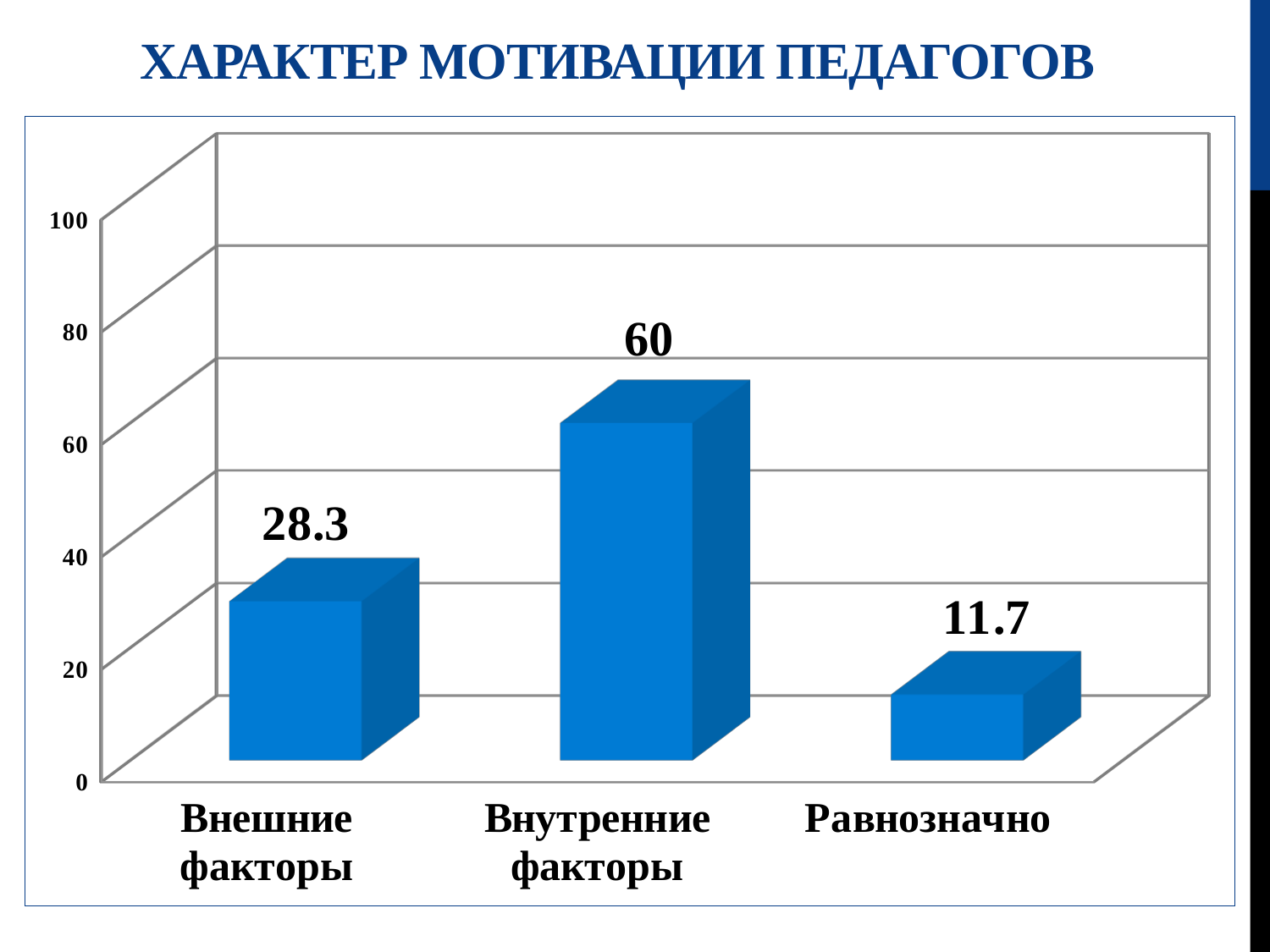
What is the value for Внешние факторы? 28.3 What is the difference between the values for Внутренние факторы and Внешние факторы? 31.7 Which category has the highest value? Внутренние факторы What is the value for Равнозначно? 11.7 How many categories are shown on the chart? 3 Which is larger, the value for Внешние факторы or the value for Равнозначно? Внешние факторы Is the value for Внутренние факторы greater or less than 40? greater Which category has the lowest value? Равнозначно What is the difference between the values for Внешние факторы and Равнозначно? 16.6 What kind of chart is shown on the slide? bar chart What is the title of the slide? ХАРАКТЕР МОТИВАЦИИ ПЕДАГОГОВ What is the value for Внутренние факторы? 60